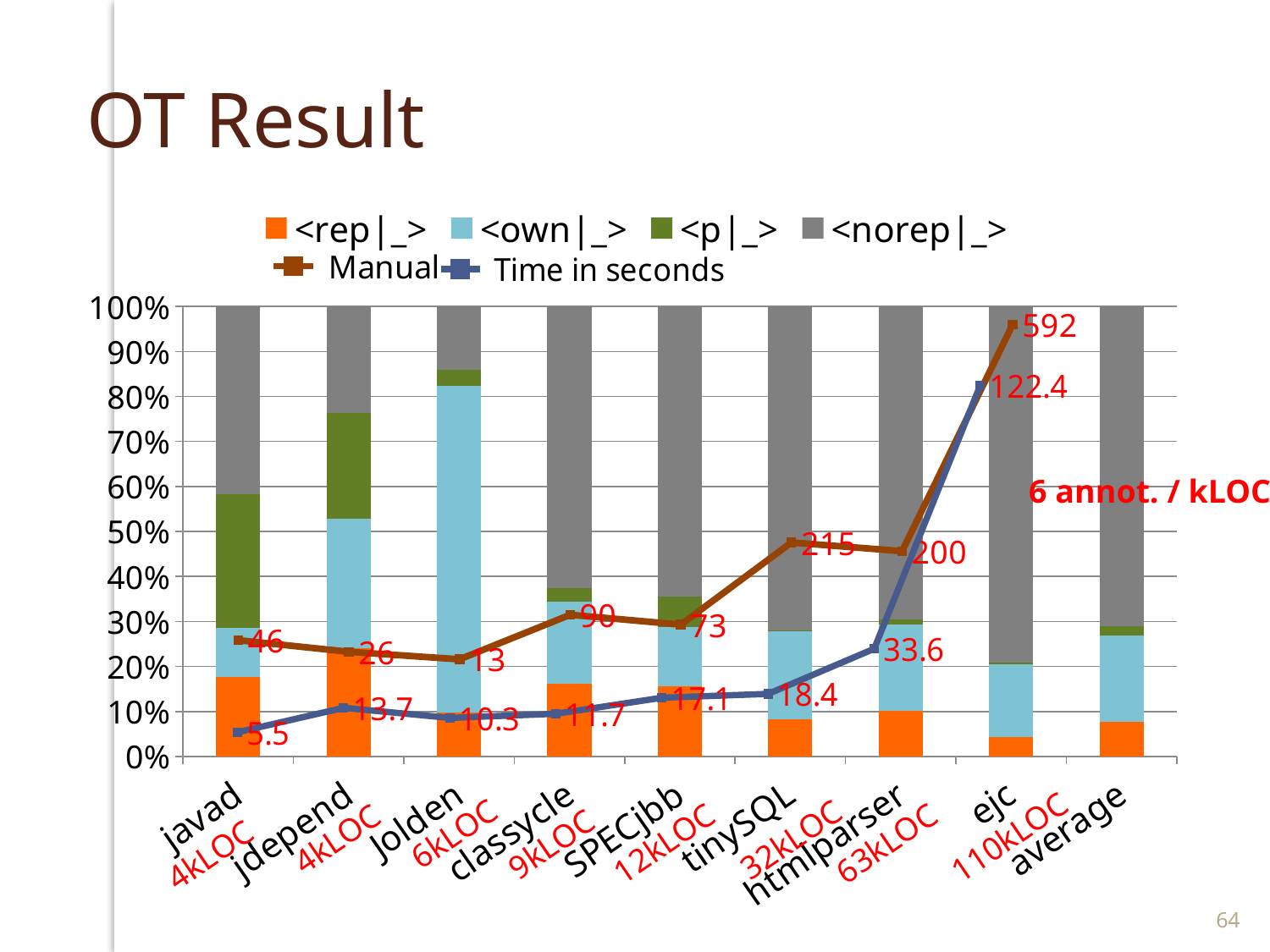
How many categories are shown on the x axis? 9 How many series does the legend list? 6 Which category has the lowest Manual value? Jolden Which has a larger Time in seconds value, jdepend or Jolden? jdepend What is the difference between the Time in seconds values for ejc and htmlparser? 88.8 Which category has the highest Manual value? ejc Which category has the lowest Time in seconds value? javad What is the Time in seconds value for ejc? 122.4 What is the difference between the Manual values for tinySQL and htmlparser? 15 What is the Manual value for classycle? 90 Does the Time in seconds series generally rise or fall from javad to ejc? rise What is the Manual value for tinySQL? 215